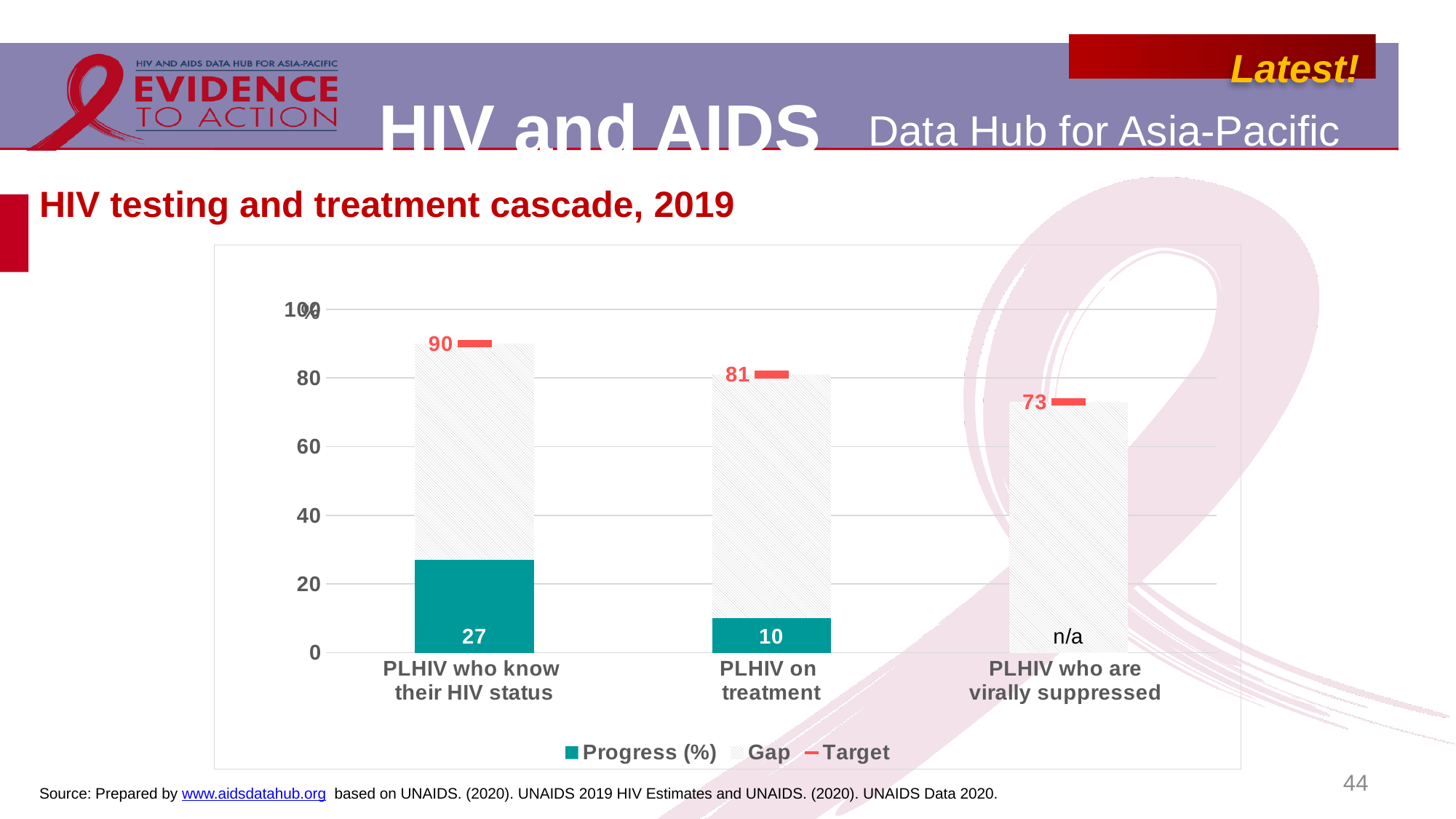
What kind of chart is shown on the slide? Bar chart How many series does the legend list? 3 What is the difference between the Progress (%) values for PLHIV who know their HIV status and PLHIV on treatment? 17 What is the Progress (%) value for PLHIV who know their HIV status? 27 Which is larger, the Progress (%) value for PLHIV who know their HIV status or for PLHIV on treatment? PLHIV who know their HIV status Which category has the lowest Target value? PLHIV who are virally suppressed What is the Target value for PLHIV who know their HIV status? 90 Which category has the highest Target value? PLHIV who know their HIV status What is the difference between the Target values for PLHIV who know their HIV status and PLHIV on treatment? 9 What is the Target value for PLHIV who are virally suppressed? 73 What is the Progress (%) value for PLHIV on treatment? 10 What is shown as the Progress (%) value for PLHIV who are virally suppressed? n/a